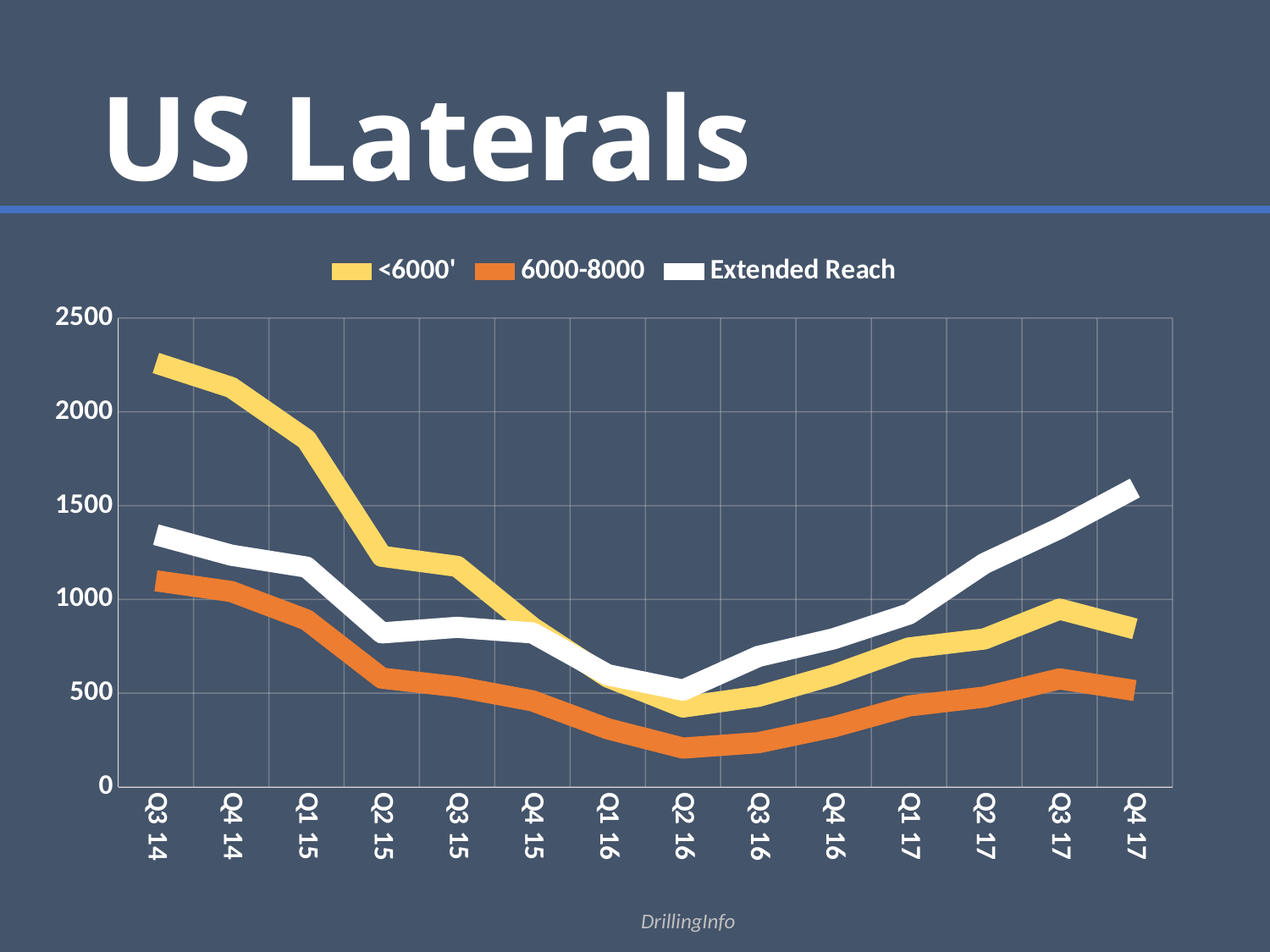
What kind of chart is shown on the slide? line chart How many quarters are plotted along the x axis? 14 Is the value for 6000-8000 at Q2 16 greater or less than 500? less Does the <6000' series rise or fall from Q3 14 to Q2 16? fall Is the value for Extended Reach at Q3 14 greater or less than 1000? greater Which series has the highest value at Q3 14? <6000' Is the value for <6000' at Q3 14 greater or less than 2000? greater In which quarter does the <6000' series reach its lowest value? Q2 16 Which series has the highest value at Q4 17? Extended Reach For Extended Reach, is the value at Q4 17 larger or smaller than the value at Q3 14? larger Which series has the lowest value at Q4 17? 6000-8000 How many series does the legend list? 3